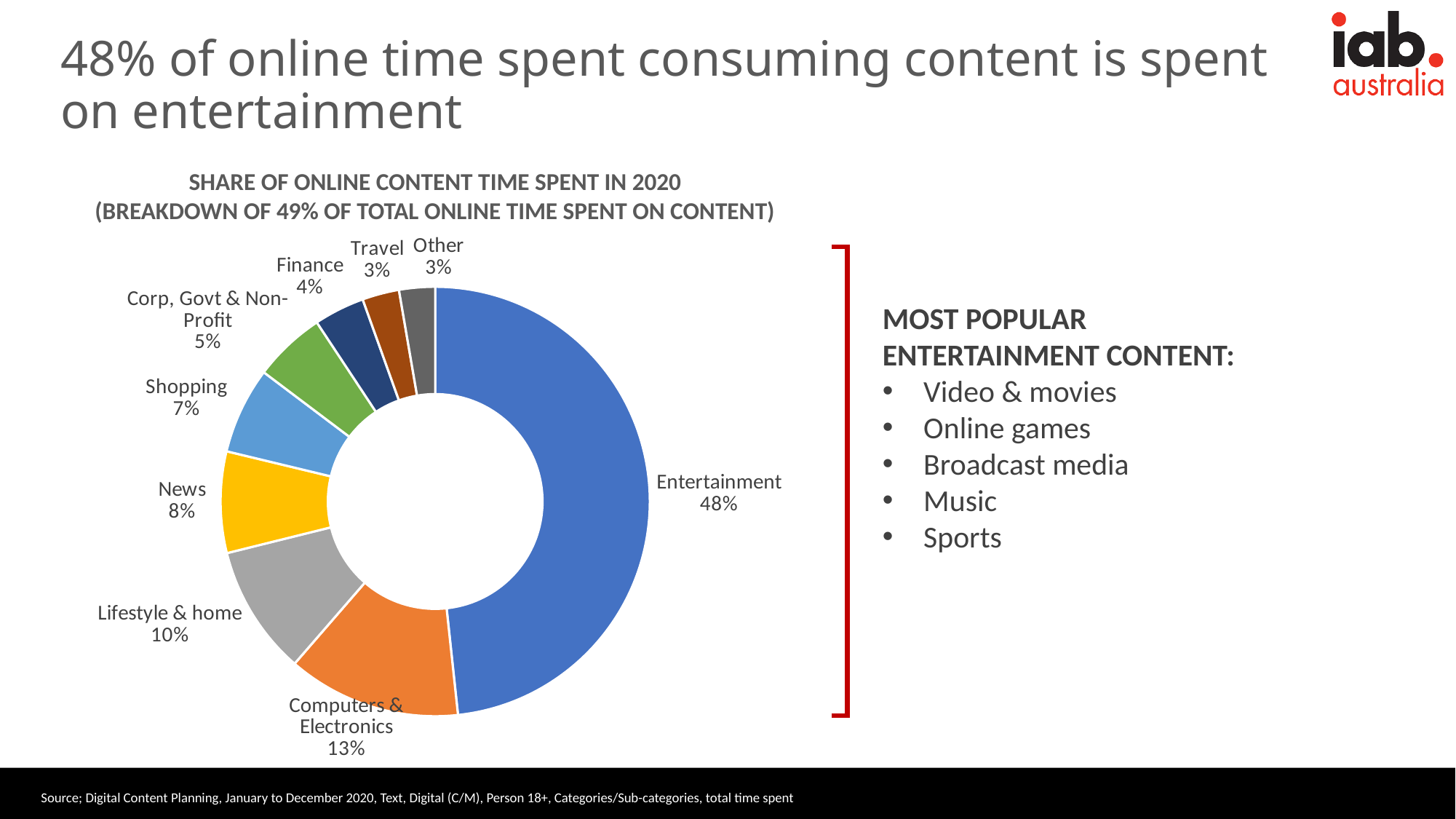
What kind of chart is shown on the slide? Doughnut chart What share of online content time spent is Entertainment? 48% What share of online content time spent is Lifestyle & home? 10% What share of online content time spent is Shopping? 7% Which category has the largest share of online content time spent? Entertainment What is the difference in share between News and Finance? 4% What is the title of the chart? Share of online content time spent in 2020 (breakdown of 49% of total online time spent on content) What share of online content time spent is Computers & Electronics? 13% How many categories are shown in the chart? 9 Which has a larger share, Lifestyle & home or Corp, Govt & Non-Profit? Lifestyle & home What is the combined share of Travel and Other? 6% What colour is the Entertainment slice? Blue